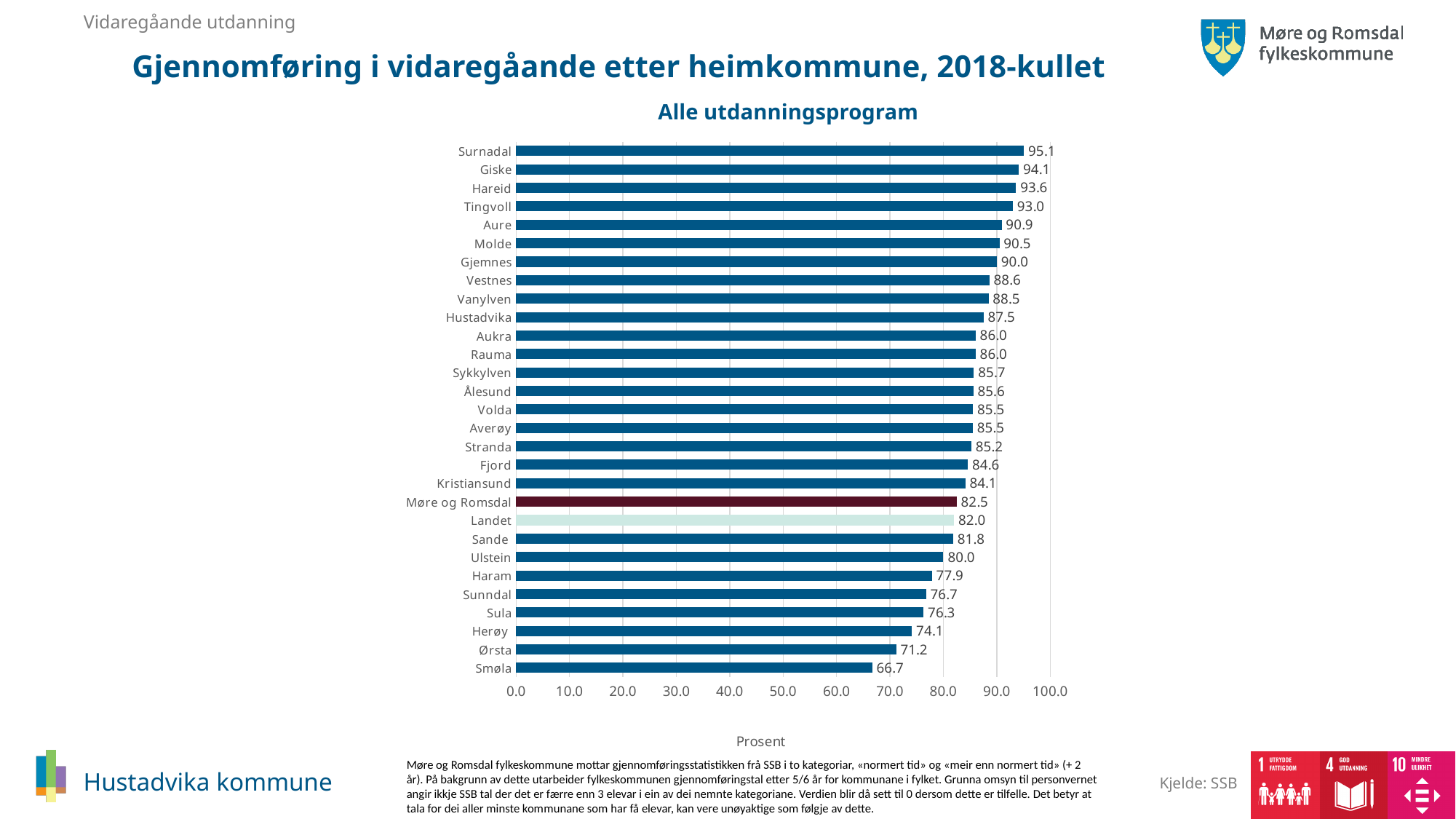
What is the value for Landet? 82.0 How many bars are shown in the chart? 29 Is the value for Ørsta greater or less than 80.0? less What is the difference between the values for Surnadal and Smøla? 28.4 What is the label on the horizontal axis of the chart? Prosent What is the value for Hustadvika? 87.5 What kind of chart is shown on the slide? Bar chart Which municipality has the lowest value? Smøla What is the value for Møre og Romsdal? 82.5 What is the difference between the values for Hustadvika and Møre og Romsdal? 5.0 Which municipality has the highest value? Surnadal Which has a larger value, Molde or Kristiansund? Molde